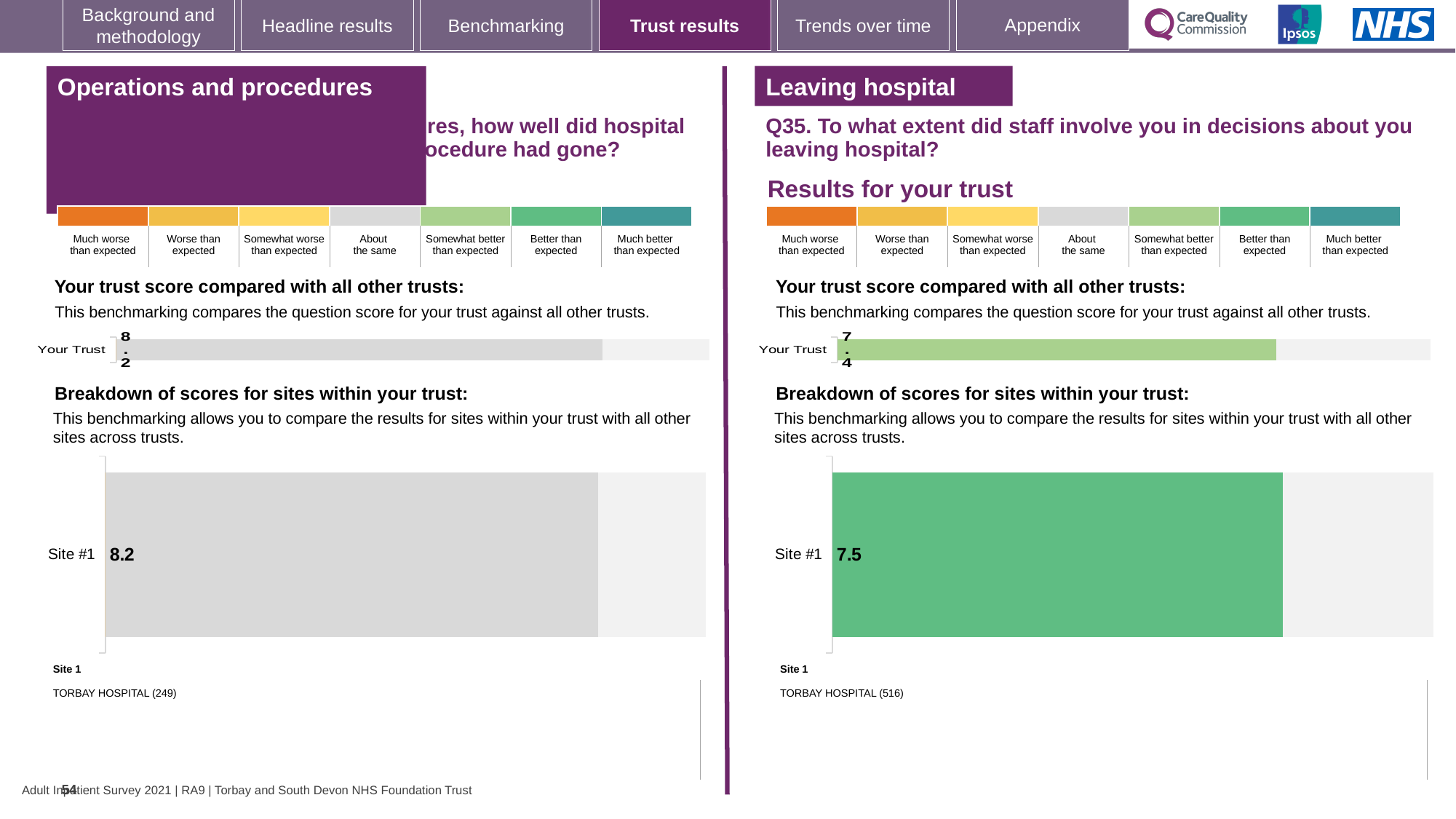
In the 'Leaving hospital' section, which benchmark category does the colour of the Site #1 bar correspond to? Better than expected Which site name is listed under Site 1 in the 'Leaving hospital' section? TORBAY HOSPITAL (516) What type of chart is used to show the Site #1 score in the 'Leaving hospital' section? Bar chart In the 'Operations and procedures' section, what is the 'Your Trust' score shown in the trust benchmarking bar chart? 8.2 In the 'Leaving hospital' section, what is the 'Your Trust' score shown in the trust benchmarking bar chart? 7.4 In the 'Operations and procedures' section, what score is shown for Site #1 in the site breakdown chart? 8.2 Which is larger: the Site #1 score in the 'Operations and procedures' section or the Site #1 score in the 'Leaving hospital' section? Operations and procedures How many sites are shown in the site breakdown chart in the 'Leaving hospital' section? 1 In the 'Leaving hospital' section, what is the difference between the Site #1 score and the 'Your Trust' score? 0.1 In the 'Operations and procedures' section, which benchmark category does the grey colour of the Site #1 bar correspond to? About the same What is the difference between the Site #1 score in the 'Operations and procedures' section and the Site #1 score in the 'Leaving hospital' section? 0.7 In the 'Leaving hospital' section, what score is shown for Site #1 in the site breakdown chart? 7.5